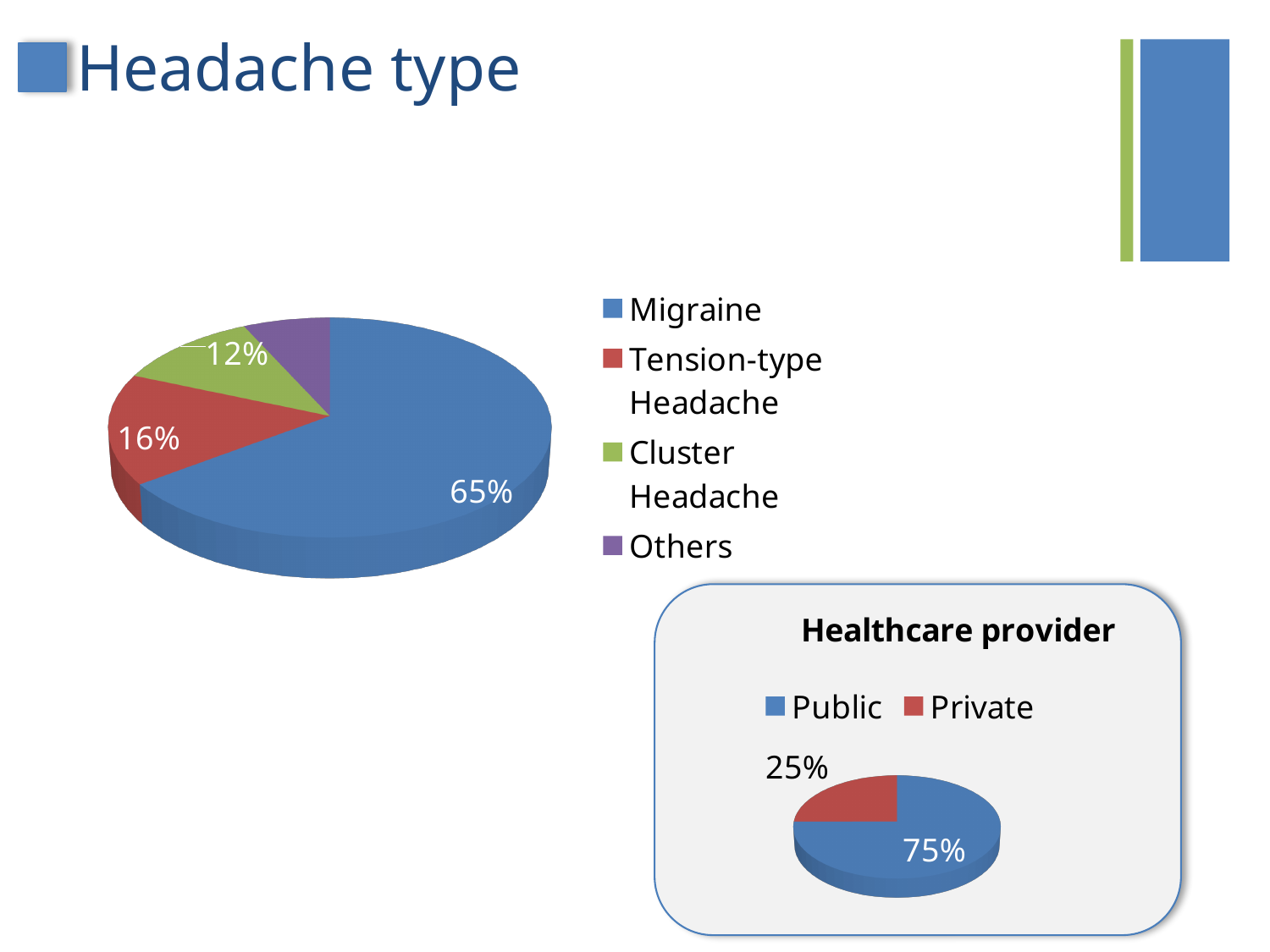
In the headache type pie chart on the left, what percentage is shown for Tension-type Headache? 16% How many categories does the legend of the headache type pie chart on the left list? 4 In the 'Healthcare provider' chart, what share is Public? 75% In the headache type pie chart on the left, which headache type has the largest slice? Migraine In the headache type pie chart on the left, what percentage is shown for Cluster Headache? 12% In the 'Healthcare provider' chart, what share is Private? 25% What kind of chart is the 'Healthcare provider' chart? Pie chart In the headache type pie chart on the left, which is larger, Tension-type Headache or Cluster Headache? Tension-type Headache In the headache type pie chart on the left, which headache type has the smallest slice? Others In the headache type pie chart on the left, what percentage is shown for Migraine? 65% In the headache type pie chart on the left, what is the difference in percentage points between Migraine and Tension-type Headache? 49 In the 'Healthcare provider' chart, what colour is the Private slice? Red